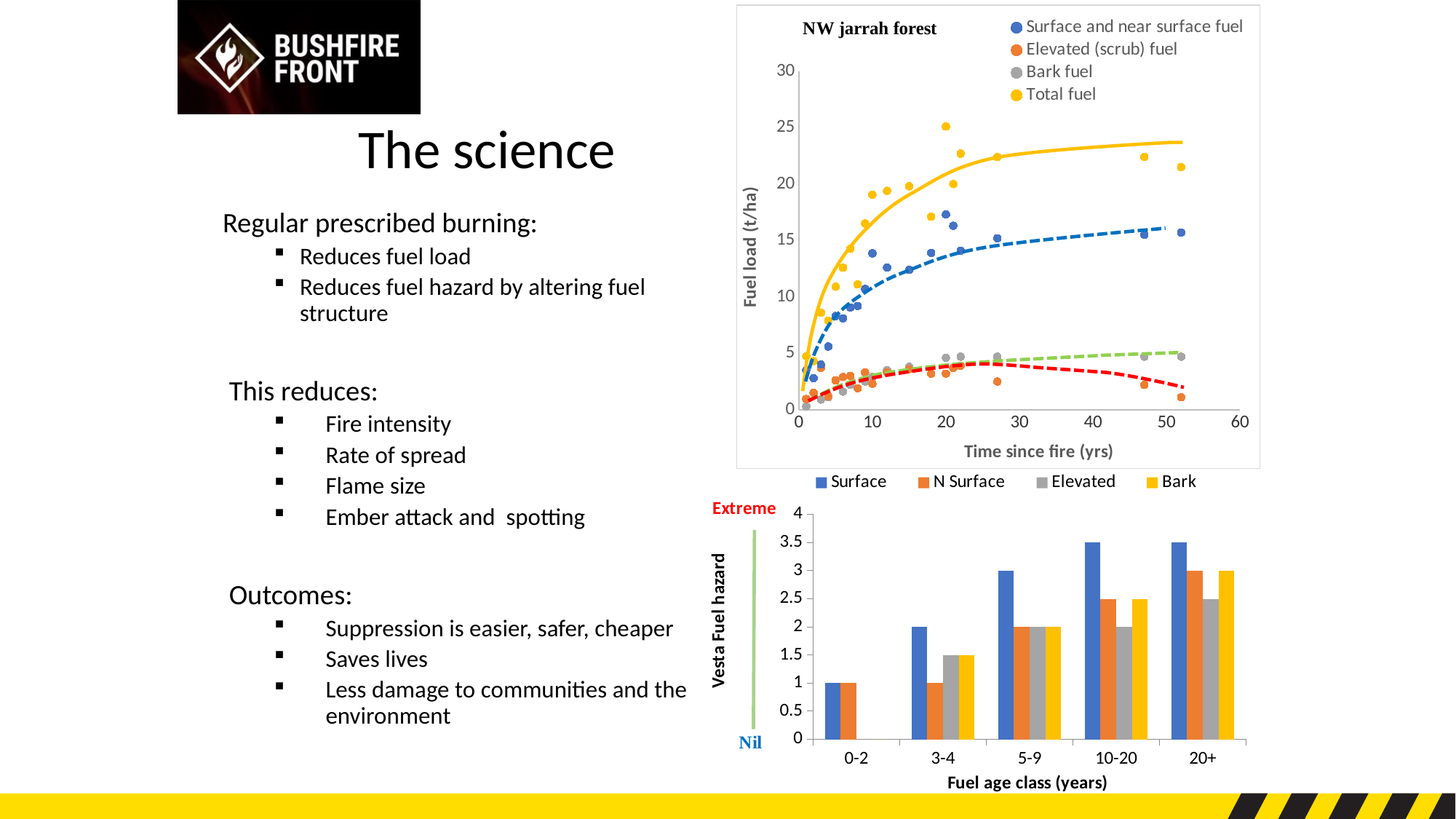
What kind of chart is the bottom chart (Vesta Fuel hazard)? Bar chart In the bottom chart (Vesta Fuel hazard), what is the difference between the Surface and Elevated values for the 10-20 fuel age class? 1.5 In the bottom chart (Vesta Fuel hazard), which fuel age class has the lowest Surface value? 0-2 In the bottom chart (Vesta Fuel hazard), what is the Bark value for the 3-4 fuel age class? 1.5 In the top chart (NW jarrah forest), does the Total fuel trend line rise or fall as time since fire increases? Rises In the bottom chart (Vesta Fuel hazard), what is the Surface value for the 5-9 fuel age class? 3 How many series does the legend of the bottom chart (Vesta Fuel hazard) list? 4 In the bottom chart (Vesta Fuel hazard), what is the N Surface value for the 20+ fuel age class? 3 In the bottom chart (Vesta Fuel hazard), which is larger for the 3-4 fuel age class: Surface or N Surface? Surface How many fuel age classes are shown on the x axis of the bottom chart (Vesta Fuel hazard)? 5 What is the x-axis title of the top chart (NW jarrah forest)? Time since fire (yrs) In the top chart (NW jarrah forest), how many series does the legend list? 4